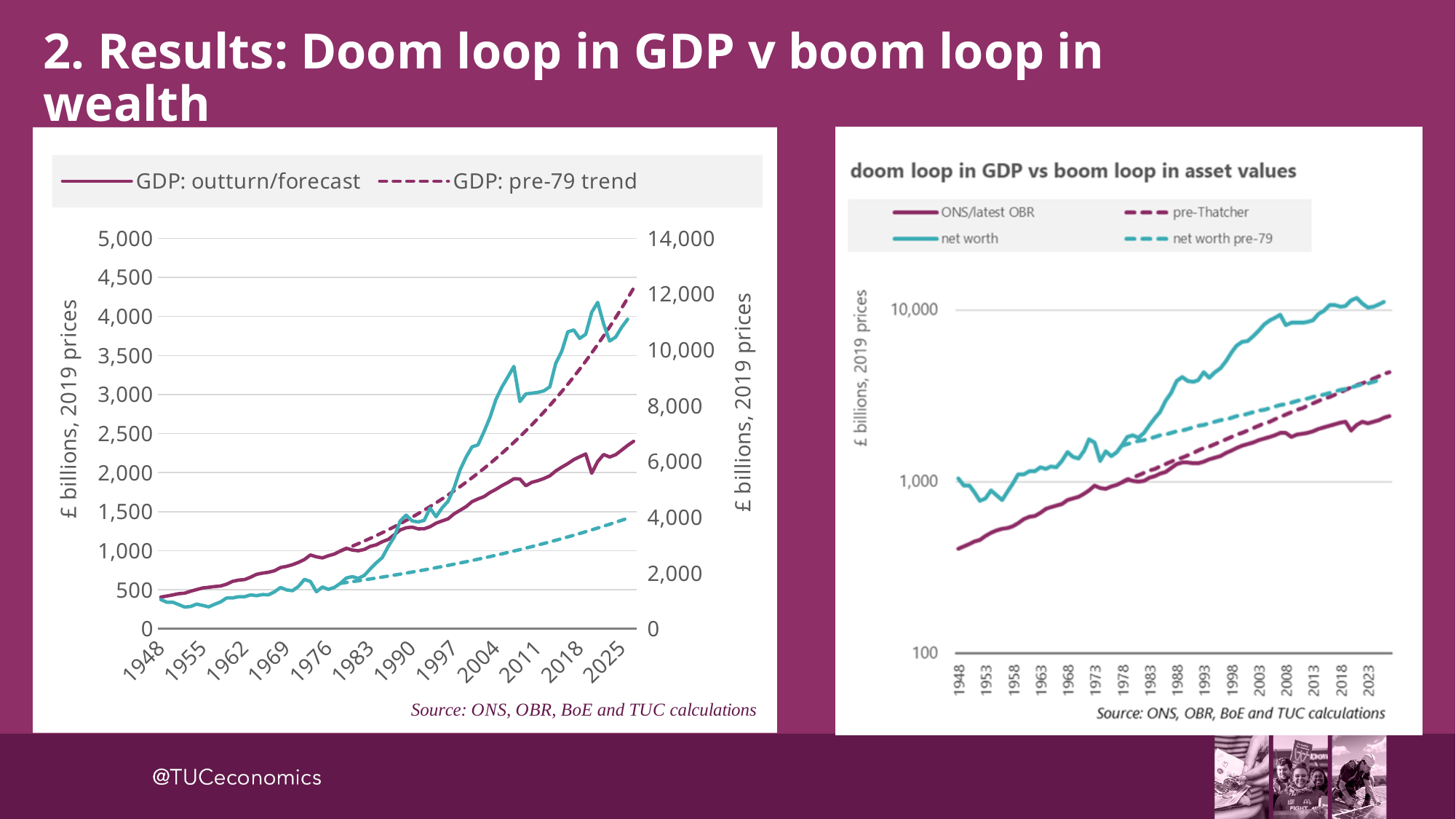
How many series does the legend of the left chart list? 2 What is the label on the left vertical axis of the left chart? £ billions, 2019 prices What is the title of the right chart? doom loop in GDP vs boom loop in asset values In the right chart, which is higher at 2023: 'net worth' or 'ONS/latest OBR'? net worth In the left chart, does the 'GDP: outturn/forecast' line rise or fall from 1948 to 2025? rise What kind of chart is the left chart? line chart How many series does the legend of the right chart, 'doom loop in GDP vs boom loop in asset values', list? 4 In the right chart, does the 'ONS/latest OBR' line rise or fall from 1948 to 2023? rise In the left chart, which is higher at 2025: 'GDP: outturn/forecast' or 'GDP: pre-79 trend'? GDP: pre-79 trend In the left chart, is the value of 'GDP: outturn/forecast' at 2025 greater or less than 2,000 on the left axis? greater